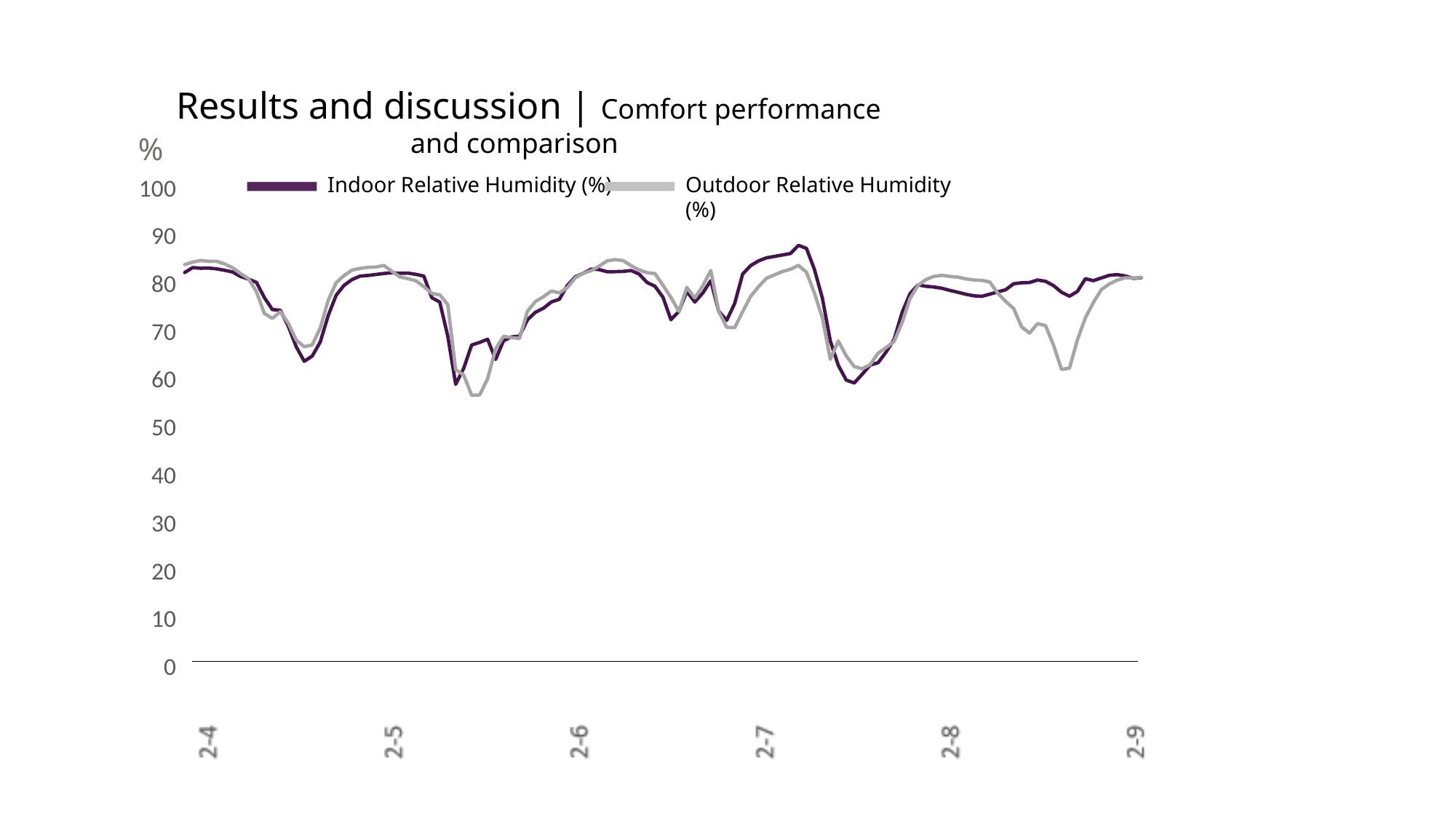
Which colour is used for the Indoor Relative Humidity (%) line? purple Is the highest Indoor Relative Humidity value on the chart greater or less than 90? less Is the Outdoor Relative Humidity value at 2-9 greater or less than 60? greater What kind of chart is shown on the slide? line chart Is the lowest Outdoor Relative Humidity value on the chart greater or less than 60? less What is the first date label on the x axis? 2-4 How many date labels are shown on the x axis? 6 What is the last date label on the x axis? 2-9 How many series does the legend list? 2 What are the two series named in the legend? Indoor Relative Humidity (%) and Outdoor Relative Humidity (%)